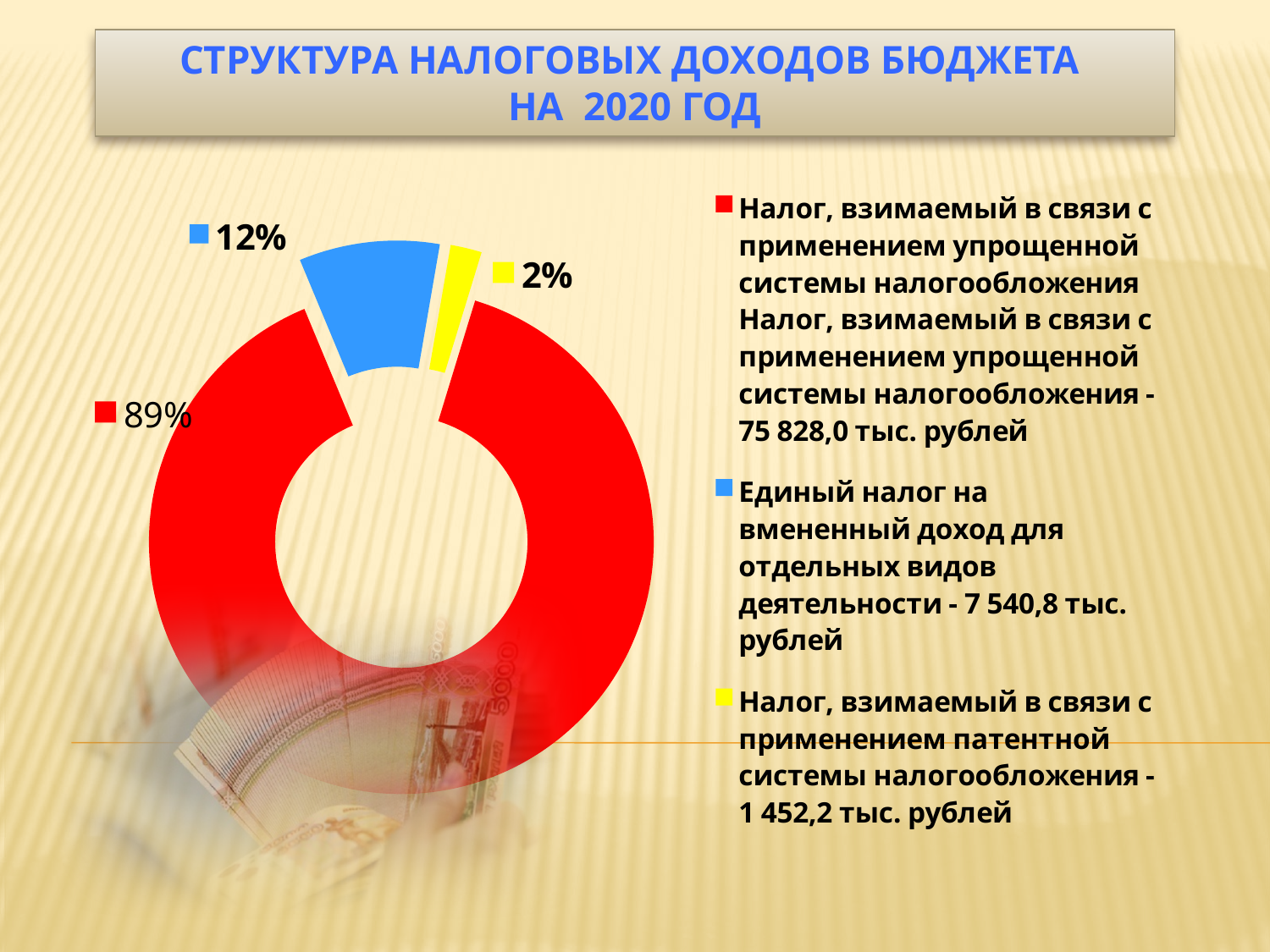
How many entries does the legend list? 3 How many slices does the chart have? 3 What is the title of the slide? СТРУКТУРА НАЛОГОВЫХ ДОХОДОВ БЮДЖЕТА НА 2020 ГОД Which category has the largest share of the chart? Налог, взимаемый в связи с применением упрощенной системы налогообложения What share of the chart does the yellow slice (Налог, взимаемый в связи с применением патентной системы налогообложения) represent? 2% Which is larger: the share for Единый налог на вмененный доход or the share for the патентной системы налогообложения tax? Единый налог на вмененный доход What share of the chart does the red slice (Налог, взимаемый в связи с применением упрощенной системы налогообложения) represent? 89% Which category has the smallest share of the chart? Налог, взимаемый в связи с применением патентной системы налогообложения What share of the chart does the blue slice (Единый налог на вмененный доход для отдельных видов деятельности) represent? 12% What colour is the slice for Единый налог на вмененный доход для отдельных видов деятельности? Blue What kind of chart is shown on the slide? Doughnut (pie) chart What is the difference in percentage points between the red slice (89%) and the blue slice (12%)? 77 percentage points